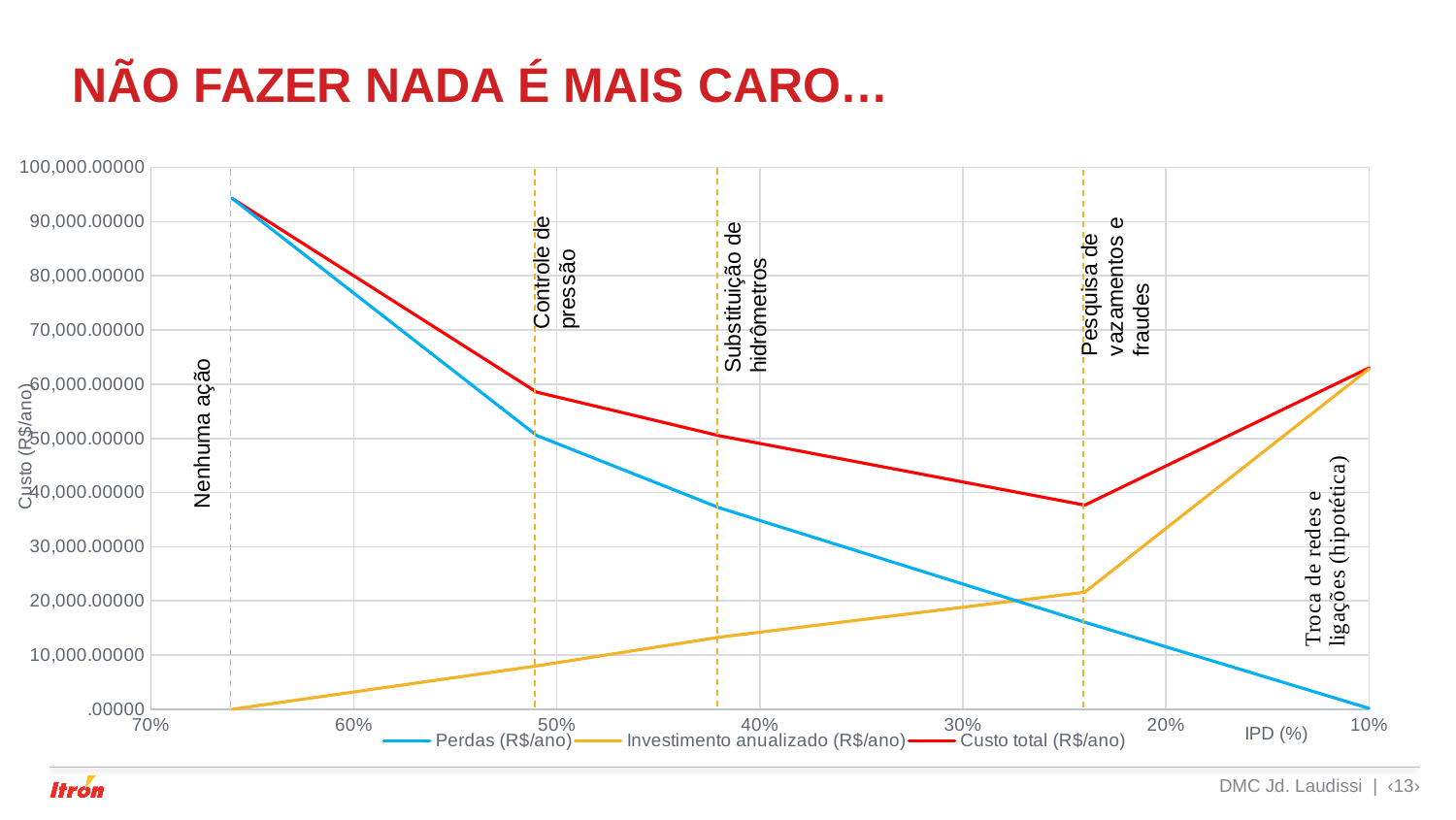
Moving from left to right along the x axis (from 70% to 10% IPD), does the Perdas (R$/ano) line rise or fall? fall Moving from left to right along the x axis (from 70% to 10% IPD), does the Investimento anualizado (R$/ano) line rise or fall? rise At the 'Substituição de hidrômetros' marker, is the Investimento anualizado (R$/ano) value greater or less than 10,000? greater At the 'Pesquisa de vazamentos e fraudes' marker, is the Custo total (R$/ano) value greater or less than 40,000? less How many series does the legend list? 3 Which series is drawn in red? Custo total (R$/ano) At 10% IPD, which is larger: Perdas (R$/ano) or Investimento anualizado (R$/ano)? Investimento anualizado (R$/ano) What kind of chart is shown on the slide? line chart At which labelled action marker does the Custo total (R$/ano) line reach its lowest point? Pesquisa de vazamentos e fraudes At 10% IPD, is the Investimento anualizado (R$/ano) value greater or less than 60,000? greater What is the title of the slide containing the chart? NÃO FAZER NADA É MAIS CARO…